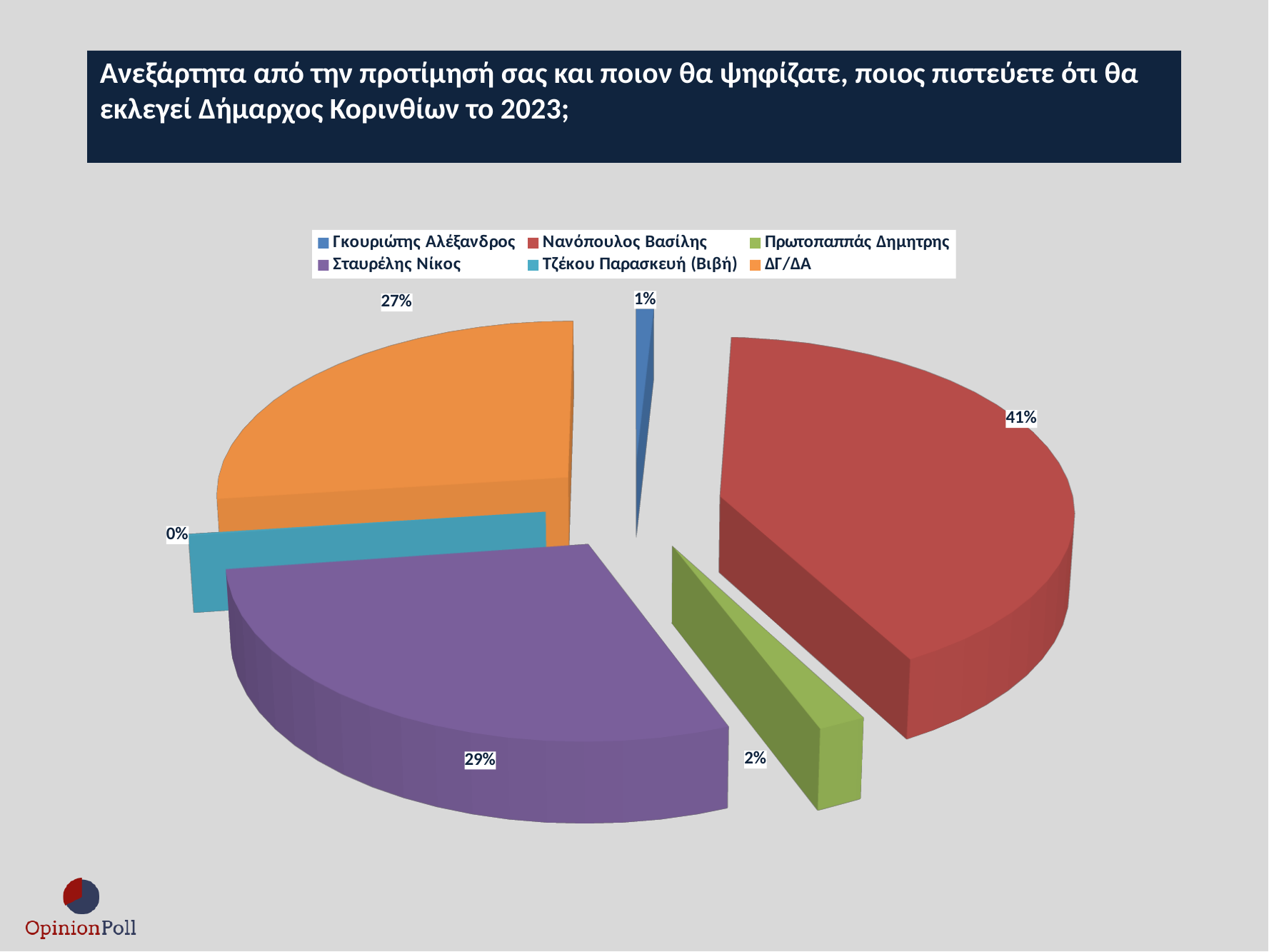
Which is larger, the share for Σταυρέλης Νίκος or the share for ΔΓ/ΔΑ? Σταυρέλης Νίκος Which legend entry has the smallest slice of the pie chart? Τζέκου Παρασκευή (Βιβή) How many entries does the legend list? 6 What is the difference in percentage points between Νανόπουλος Βασίλης and Σταυρέλης Νίκος? 12 What type of chart is shown on the slide? Pie chart What percentage of respondents believe Νανόπουλος Βασίλης will be elected mayor? 41% Which candidate has the largest slice of the pie chart? Νανόπουλος Βασίλης What percentage is shown for ΔΓ/ΔΑ? 27% What share does Σταυρέλης Νίκος have in the pie chart? 29% What percentage is shown for Γκουριώτης Αλέξανδρος? 1% What percentage is shown for Πρωτοπαππάς Δημήτρης? 2% What percentage is shown for Τζέκου Παρασκευή (Βιβή)? 0%